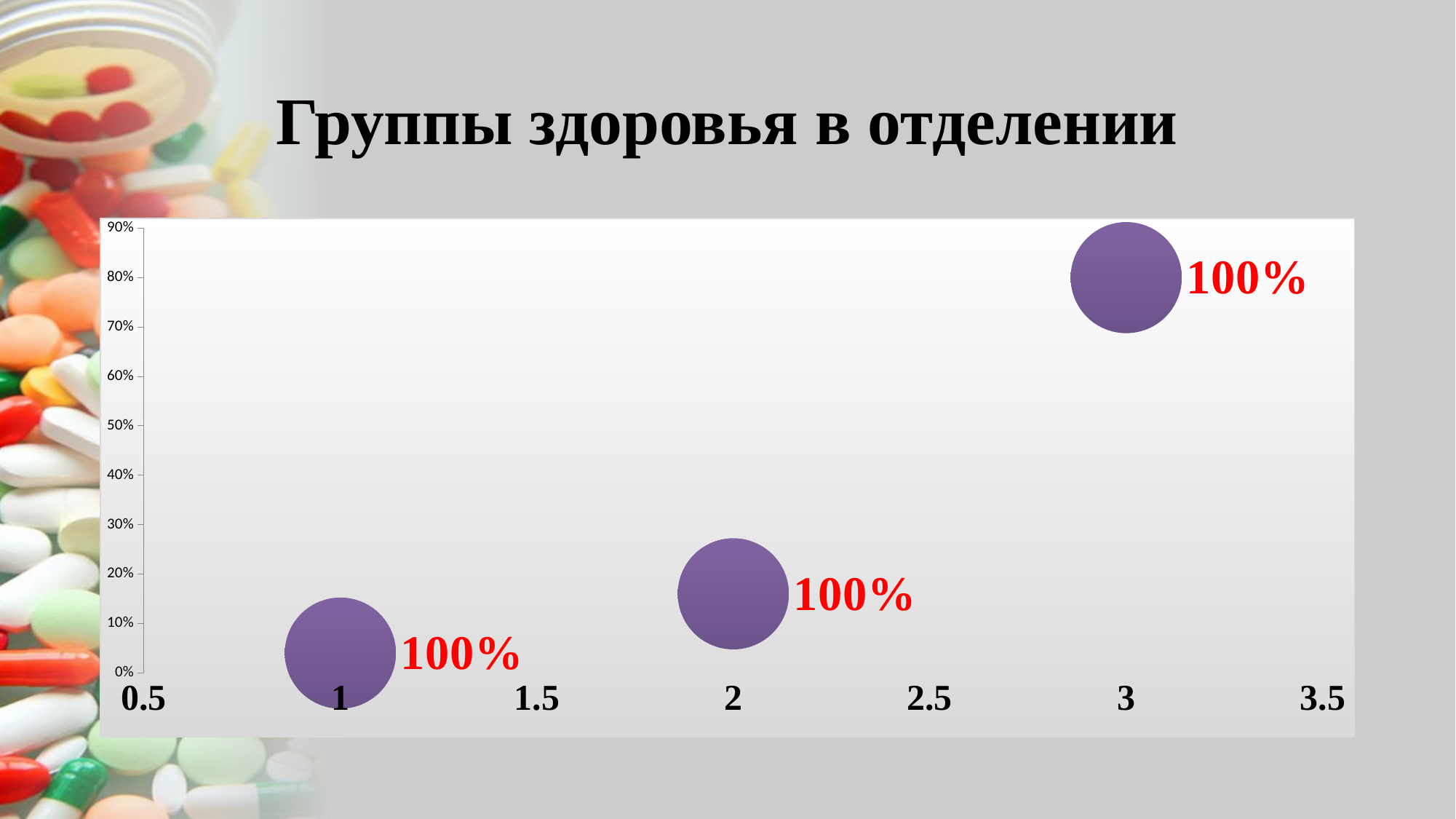
At which x position is the bubble plotted lowest on the vertical axis? 1 Is the vertical position of the bubble at x = 1 greater or less than 10%? less Do the bubbles rise or fall along the x axis from left to right? rise What data label is printed next to the bubble at x = 1? 100% Is the vertical position of the bubble at x = 2 greater or less than 30%? less Which bubble is plotted higher on the vertical axis, the one at x = 2 or the one at x = 3? the one at x = 3 What is the title of the chart? Группы здоровья в отделении How many bubbles are plotted on the chart? 3 Is the vertical position of the bubble at x = 3 greater or less than 70%? greater What data label is printed next to the bubble at x = 3? 100% What kind of chart is shown on the slide? bubble chart At which x position is the bubble plotted highest on the vertical axis? 3